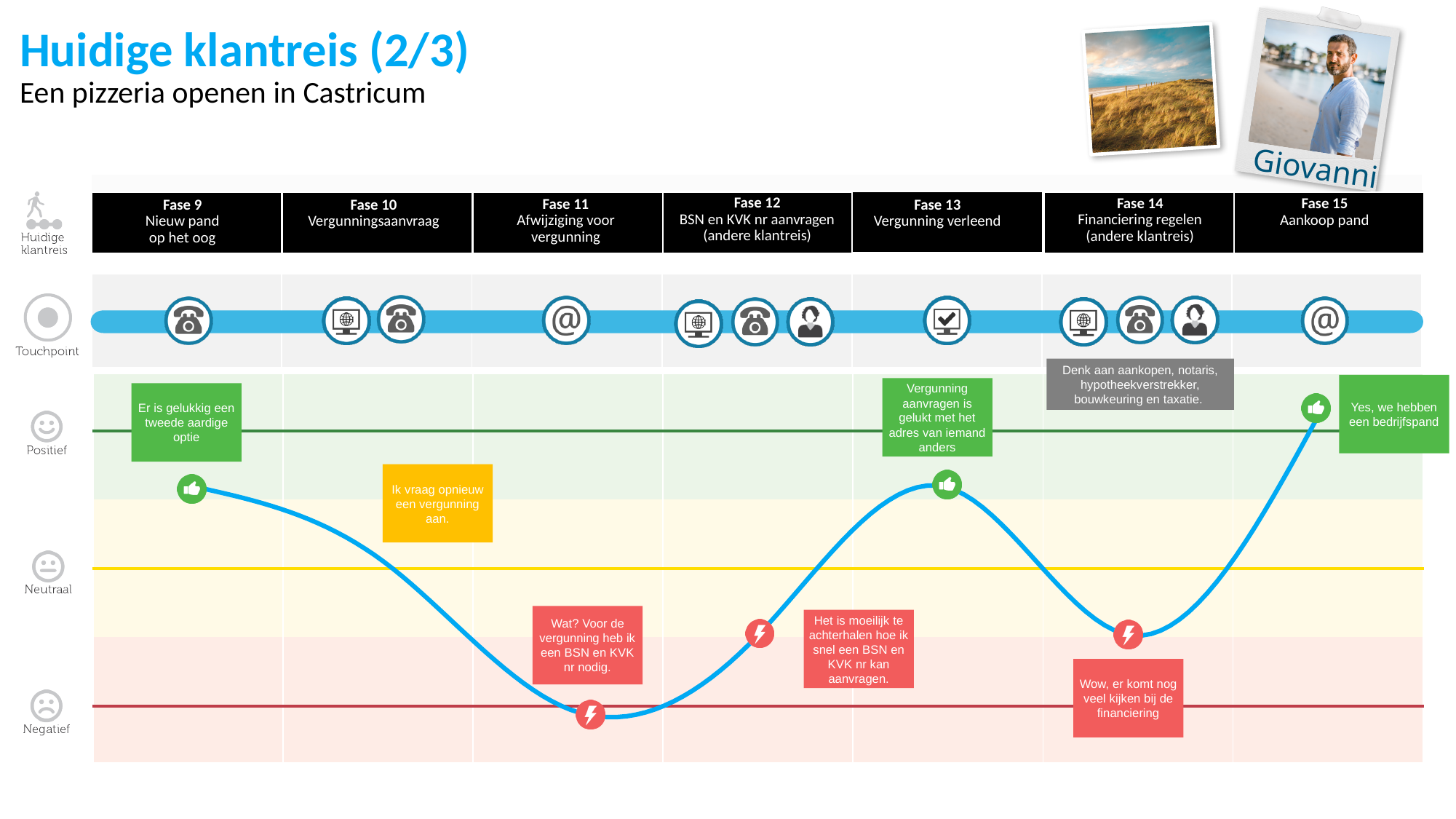
What is the title of the slide? Huidige klantreis (2/3) In which phase does the emotion line reach its highest point? Fase 15 (Aankoop pand) How many phases (Fase) are shown along the top of the journey map? 7 Does the emotion line rise or fall from Fase 13 to Fase 14? fall In which emotion zone (Positief, Neutraal or Negatief) is the point for Fase 11? Negatief In which phase does the emotion line reach its lowest point? Fase 11 (Afwijziging voor vergunning) Which is higher on the emotion line: the peak in Fase 13 or the peak in Fase 15? Fase 15 How many lightning (negative) markers are placed on the emotion line? 3 Does the emotion line rise or fall from Fase 9 to Fase 11? fall How many touchpoint icons are shown for Fase 12? 3 What kind of chart is used to show the customer's emotion across the phases? line chart Does the emotion line rise or fall from Fase 11 to Fase 13? rise